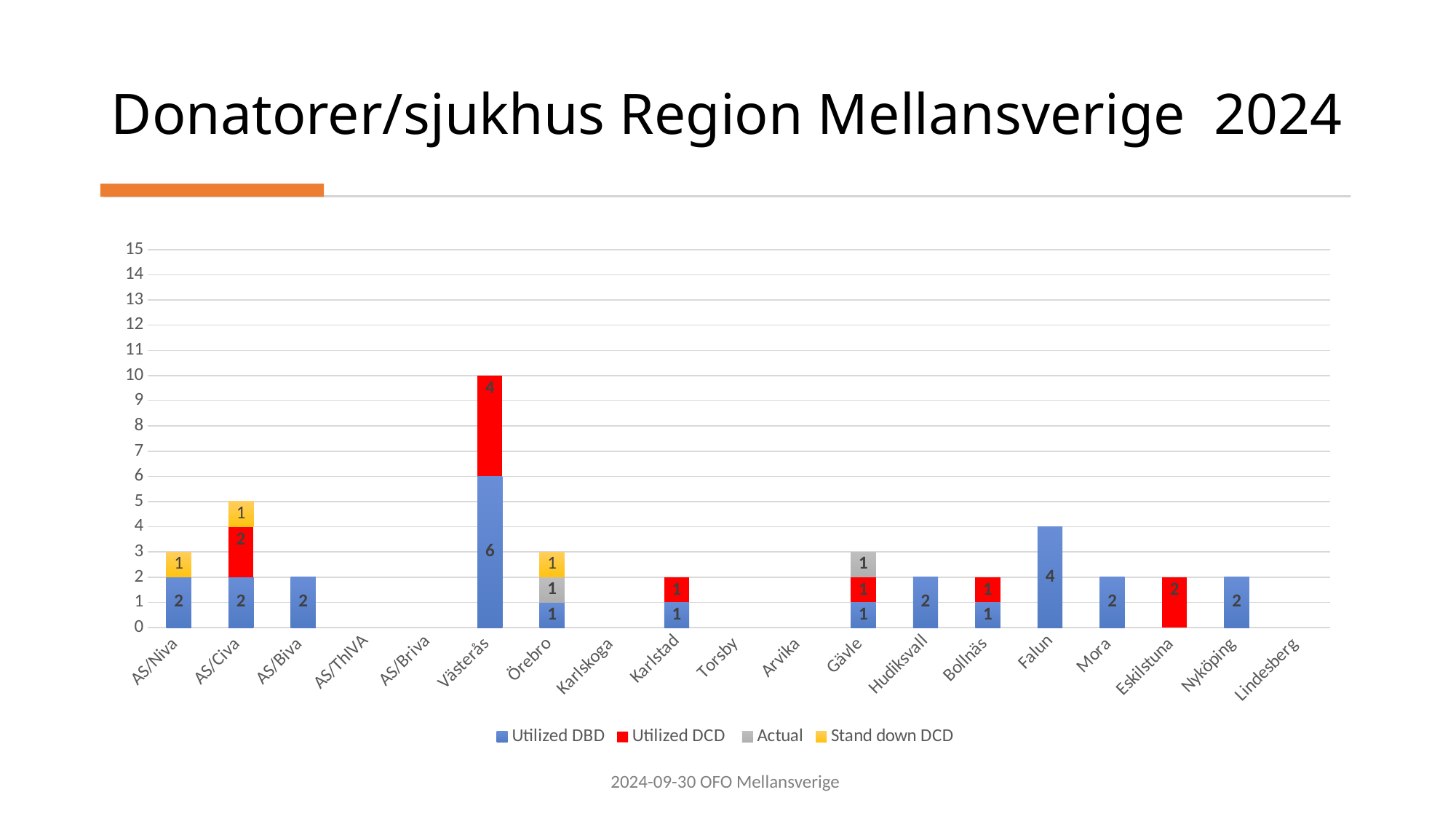
What is the Utilized DCD value for Västerås? 4 What is the Utilized DCD value for Eskilstuna? 2 What is the total of the stacked bar for AS/Civa? 5 Which hospital has the tallest stacked bar? Västerås How many hospital categories are shown on the x axis? 19 What type of chart is shown on the slide? Stacked bar chart How many series does the legend list? 4 What is the Utilized DBD value for Falun? 4 What is the Utilized DBD value for Västerås? 6 What is the total of the stacked bar for Örebro? 3 Which is larger, the Utilized DBD value for Hudiksvall or for Falun? Falun What is the difference between the Utilized DBD values for Västerås and Falun? 2